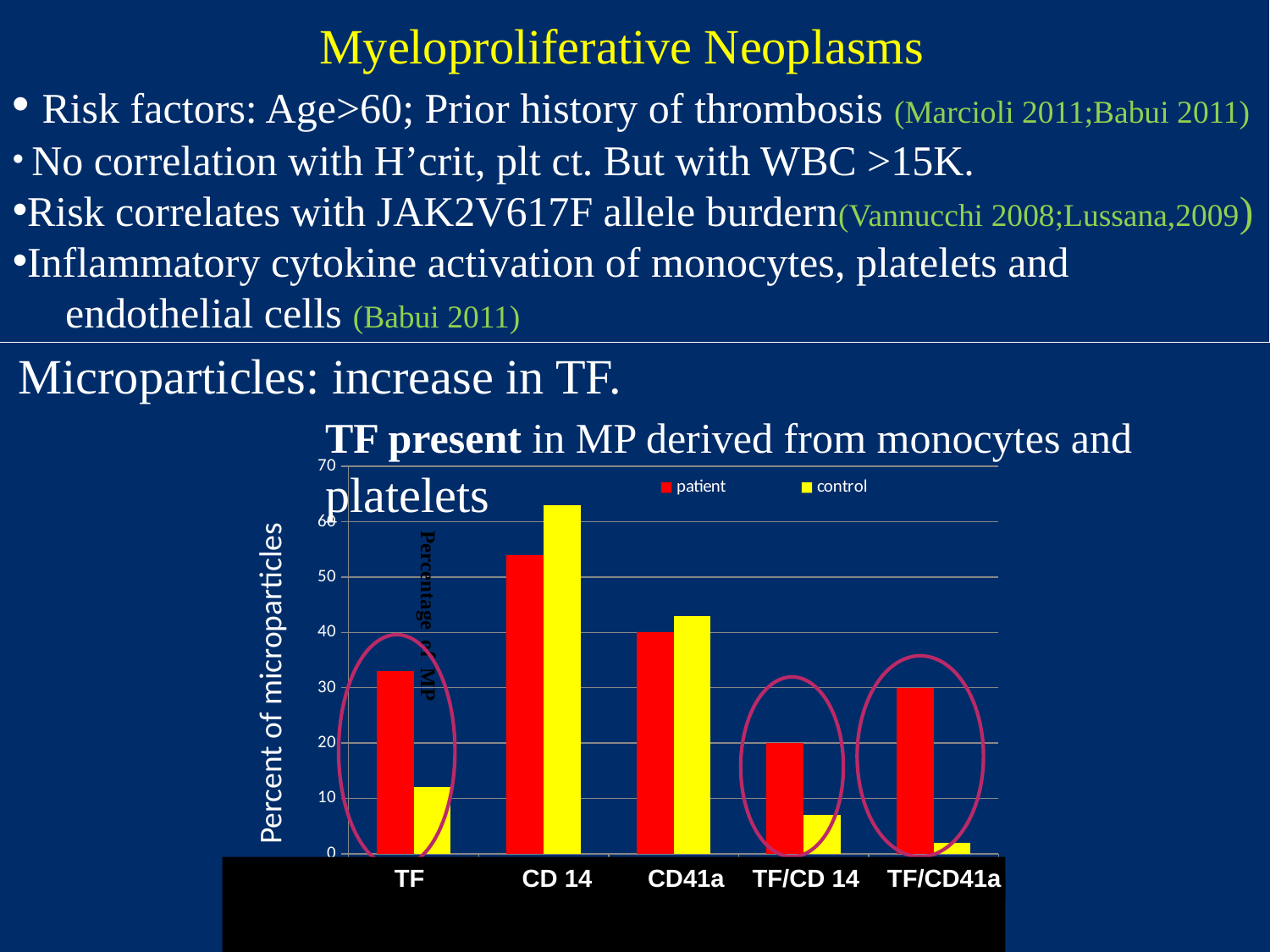
Which colour represents the control series in the chart? yellow For TF, which is larger, the patient value or the control value? patient How many series does the chart legend list? 2 How many categories are shown on the x axis of the chart? 5 Is the control value for TF/CD 14 greater or less than 10? less Which category has the lowest control bar? TF/CD41a What kind of chart is shown on the slide? bar chart For CD 14, which is larger, the patient value or the control value? control Which category has the highest patient bar? CD 14 Which category has the lowest patient bar? TF/CD 14 Which category has the highest control bar? CD 14 Is the control value for CD 14 greater or less than 60? greater